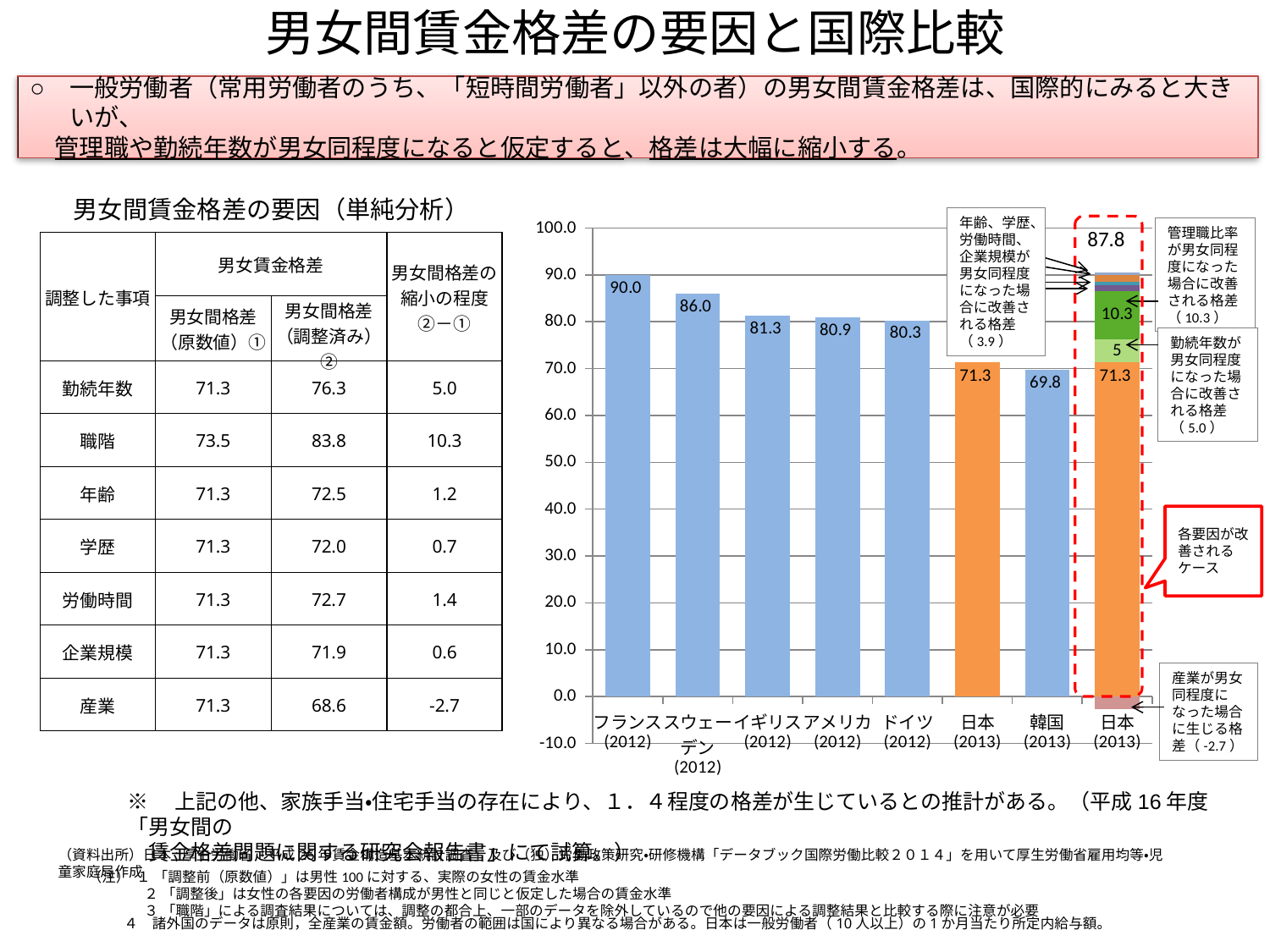
Which country has the lowest bar in the chart? 韓国 (2013) What is the total shown at the top of the stacked bar for 日本 (2013) on the far right? 87.8 Which country has the highest plain (non-stacked) bar in the chart? フランス (2012) What is the value for 韓国 (2013) in the bar chart? 69.8 What is the value for ドイツ (2012) in the bar chart? 80.3 Which is larger, the value for イギリス (2012) or アメリカ (2012)? イギリス (2012) What is the value for フランス (2012) in the bar chart? 90.0 Is the value for ドイツ (2012) greater or less than 80.0? greater What kind of chart is shown on the slide? bar chart What is the value for スウェーデン (2012) in the bar chart? 86.0 What is the value of the green segment (管理職比率) in the stacked 日本 (2013) bar? 10.3 What is the difference between the values for フランス (2012) and 日本 (2013) (the plain bar)? 18.7